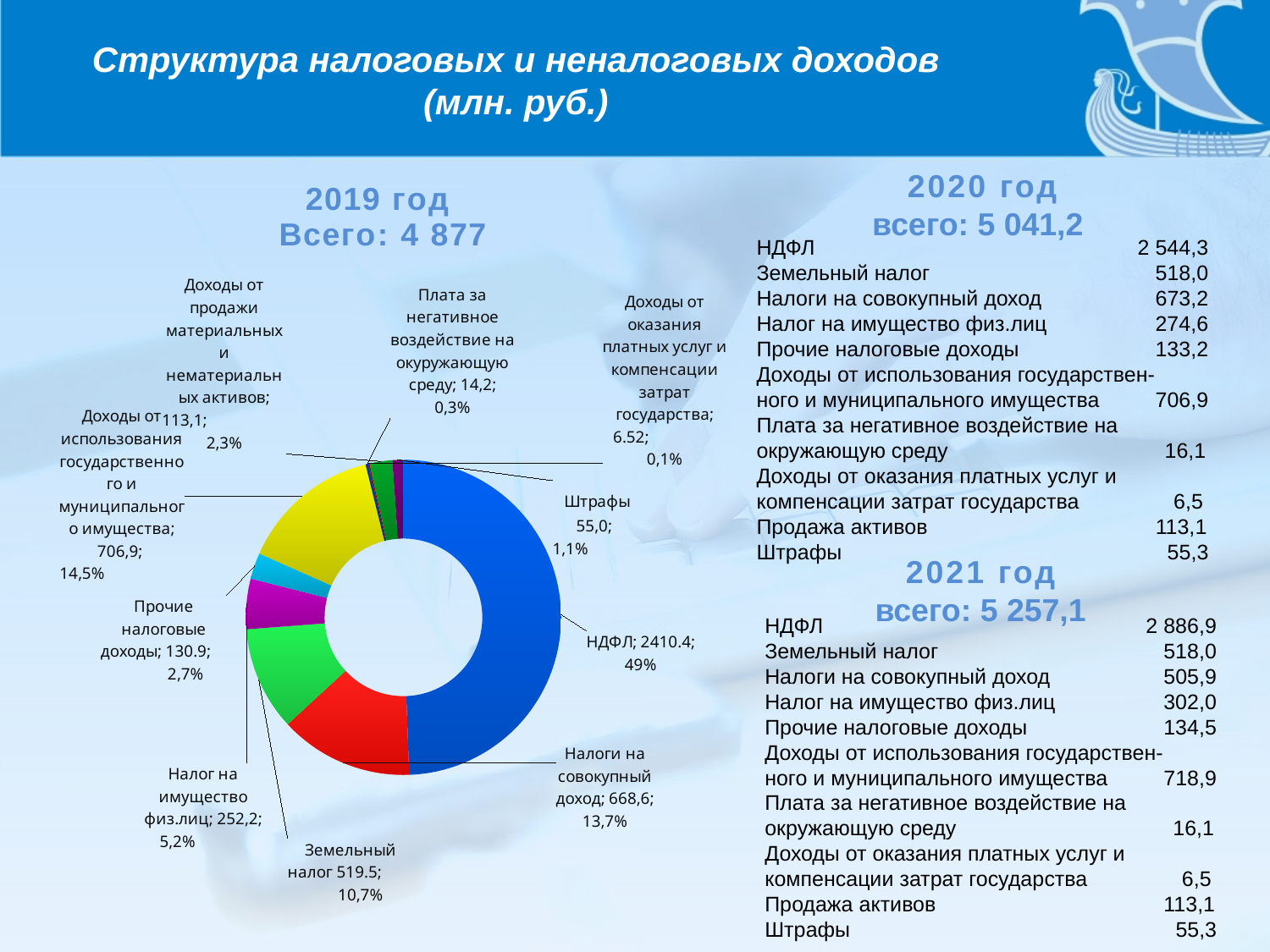
In the 2019 chart, what is the difference between Налоги на совокупный доход (668,6) and Налог на имущество физ.лиц (252,2)? 416,4 What total is stated in the heading above the 2019 chart? 4 877 Which category has the smallest value in the 2019 chart? Доходы от оказания платных услуг и компенсации затрат государства What is the value for Налоги на совокупный доход in the 2019 chart? 668,6 What percentage share is shown for Доходы от использования государственного и муниципального имущества in the 2019 chart? 14,5% Which category has the largest value in the 2019 chart? НДФЛ What is the value for НДФЛ in the 2019 chart? 2410.4 How many categories are shown in the 2019 chart? 10 In the 2019 chart, which is larger: Земельный налог or Налоги на совокупный доход? Налоги на совокупный доход What type of chart is shown on the slide? Doughnut (pie) chart What share of the 2019 chart does НДФЛ account for? 49% What is the value for Земельный налог in the 2019 chart? 519.5